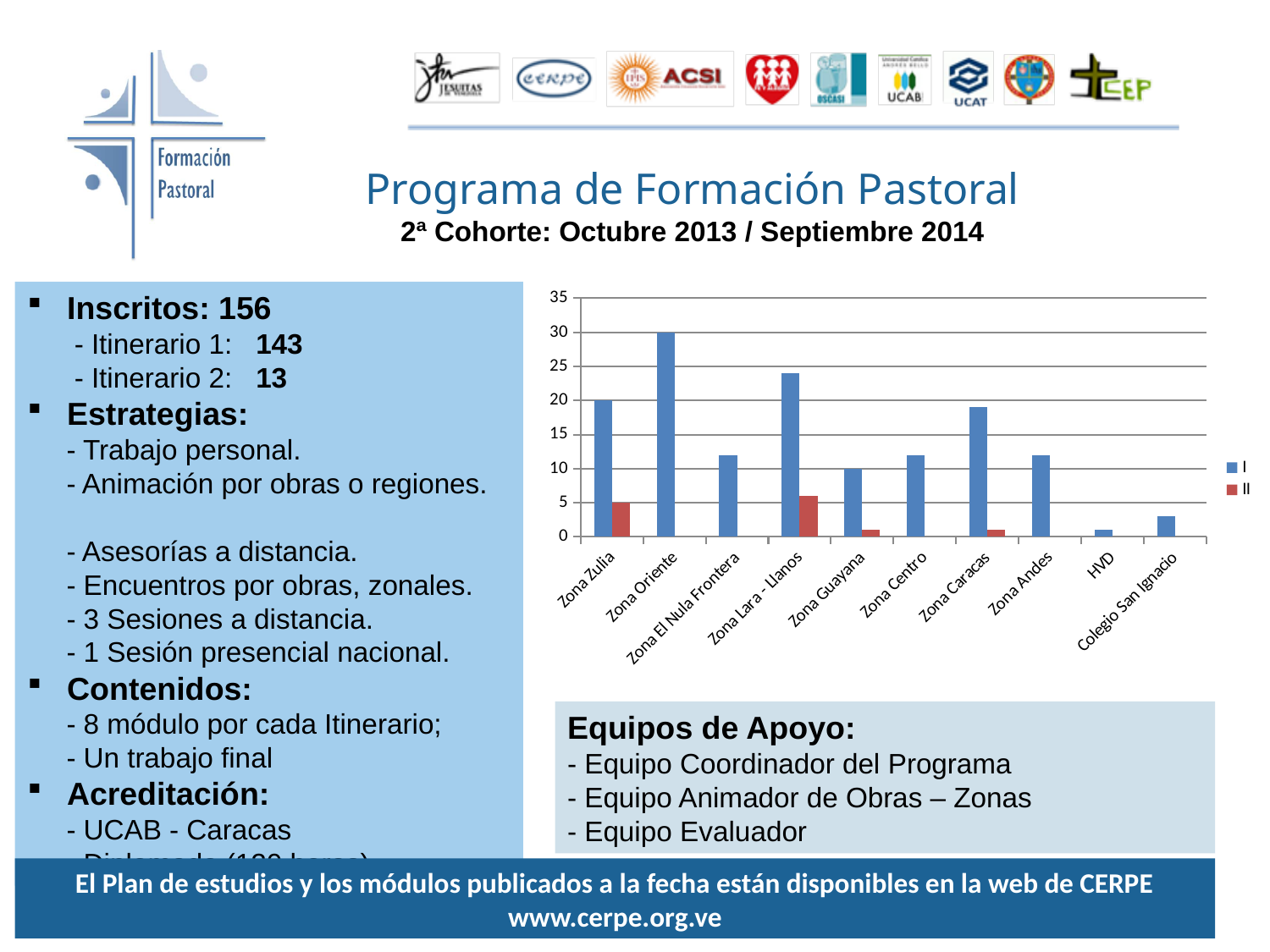
Is the value for series I for Zona El Nula Frontera greater or less than 10? greater What is the value for series I for Zona Zulia? 20 What is the value for series I for Zona Oriente? 30 What kind of chart is shown on the slide? bar chart Which category has the lowest value for series I? HVD Which category has the highest value for series I? Zona Oriente How many series does the chart legend list? 2 Is the value for series I for Zona Lara - Llanos greater or less than 20? greater How many categories are shown on the x axis of the chart? 10 Which is larger for series I: Zona Oriente or Zona Lara - Llanos? Zona Oriente What are the two entries listed in the chart legend? I and II Is the value for series I for Colegio San Ignacio greater or less than 5? less